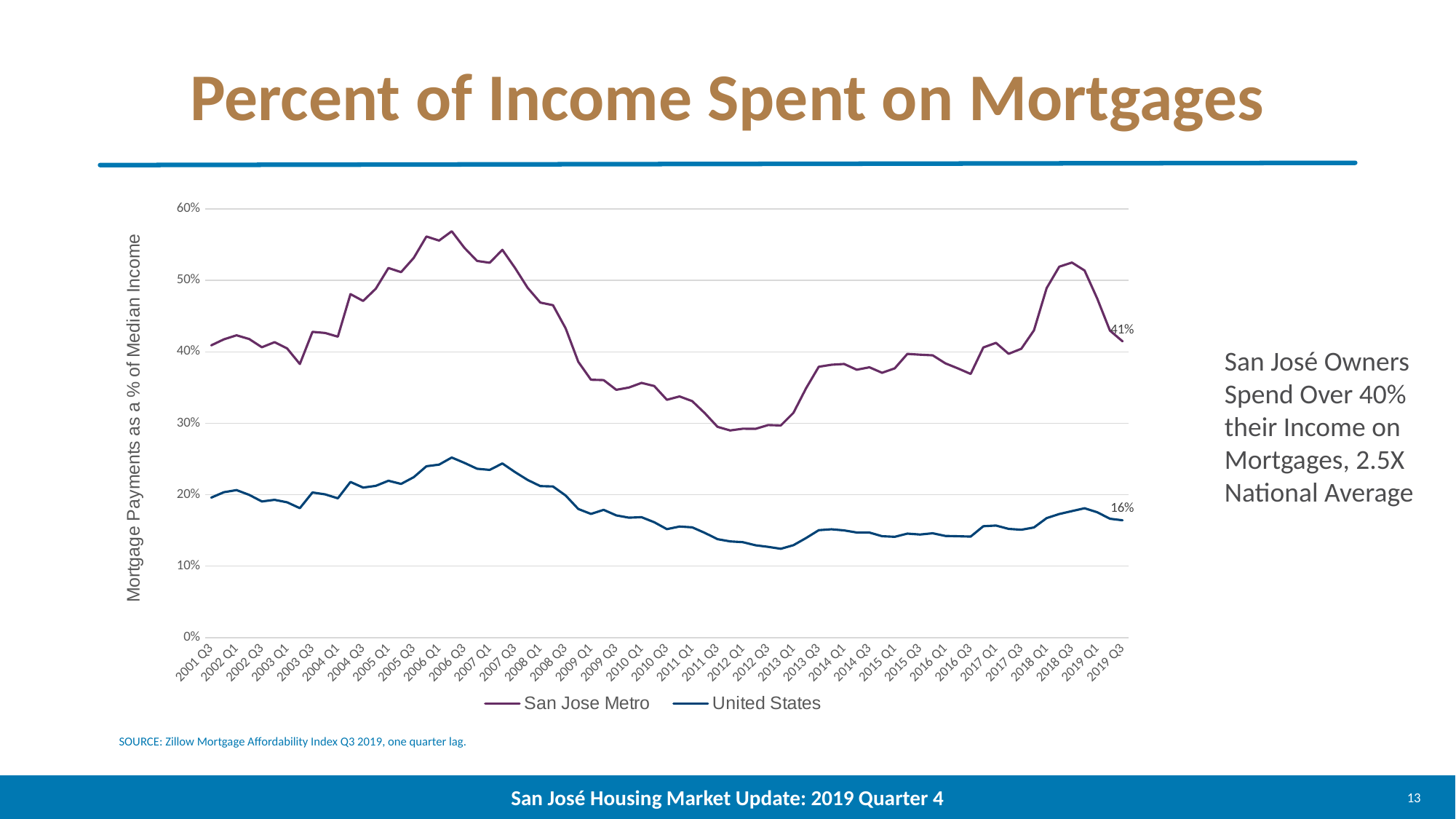
Does the San Jose Metro line rise or fall between 2018 Q3 and 2019 Q3? Falls What is the difference between the San Jose Metro and United States values at 2019 Q3? 25 percentage points What kind of chart is shown on the slide? Line chart Which series reaches the highest value on the chart? San Jose Metro At 2019 Q3, which series has the higher value, San Jose Metro or United States? San Jose Metro Is the value for United States at 2012 Q3 greater or less than 20%? less What is the labeled value for San Jose Metro at 2019 Q3? 41% Is the value for San Jose Metro at 2006 Q3 greater or less than 50%? greater How many series does the legend list? 2 What is the labeled value for United States at 2019 Q3? 16% What is the title of the vertical axis? Mortgage Payments as a % of Median Income Is the value for San Jose Metro at 2012 Q1 greater or less than 40%? less